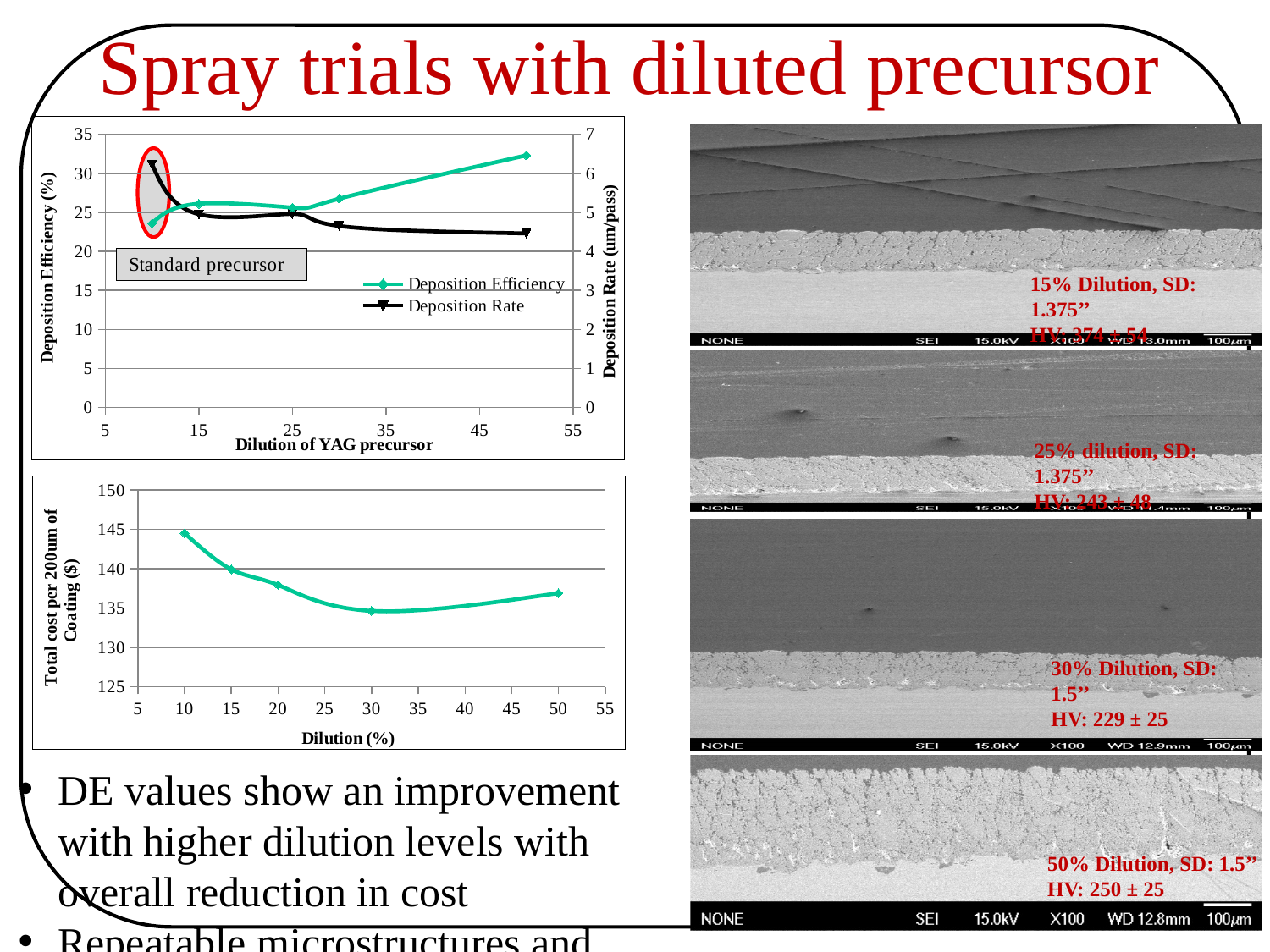
In the top chart, is the Deposition Efficiency at 50% dilution greater or less than 30? greater In the top chart, at which dilution level is Deposition Rate lowest? 50 What kind of chart is the top chart (Deposition Efficiency / Deposition Rate vs Dilution of YAG precursor)? line chart In the top chart, is the Deposition Rate at 50% dilution greater or less than 5? less In the bottom chart, at which dilution is the total cost per 200um of coating highest? 10 In the bottom chart (Total cost per 200um of Coating), how many data points are plotted? 5 In the top chart, at which dilution level is Deposition Efficiency highest? 50 In the top chart, does Deposition Rate rise or fall as dilution increases from 10 to 50? fall How many series does the legend of the top chart list? 2 What are the two series named in the legend of the top chart? Deposition Efficiency and Deposition Rate In the bottom chart, which is larger: the total cost at 10% dilution or at 50% dilution? 10% dilution In the bottom chart, is the total cost at 10% dilution greater or less than 140? greater